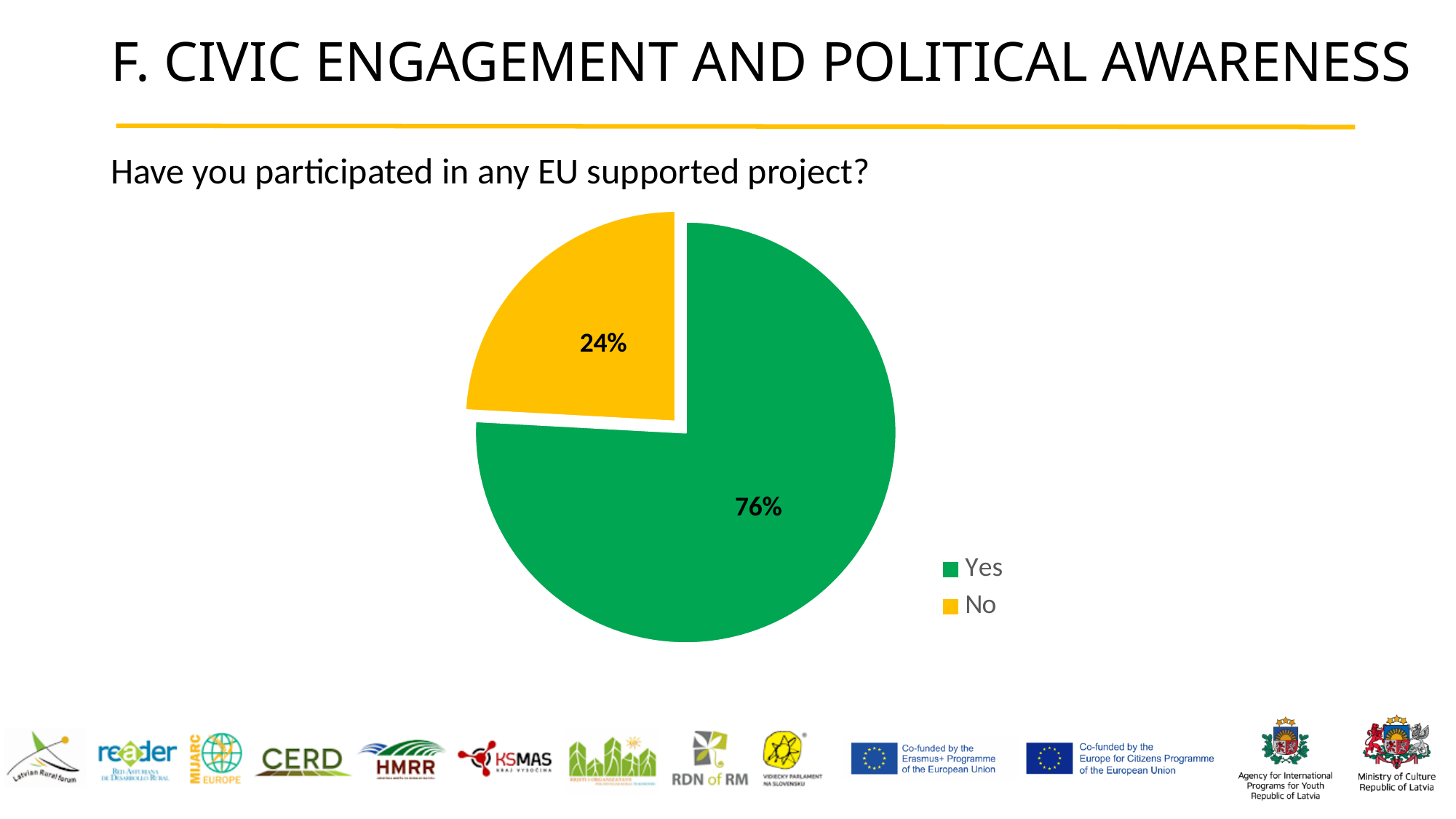
What type of chart is shown on the slide? Pie chart Which is larger, the share for Yes or the share for No? Yes What question does the pie chart present responses to? Have you participated in any EU supported project? What percentage of respondents answered Yes to having participated in an EU supported project? 76% What percentage of respondents answered No to having participated in an EU supported project? 24% What share of the pie does the No slice represent? 24% How many slices does the pie chart have? 2 Which response has the smallest share of the pie chart? No How many entries does the legend list? 2 What is the difference in percentage points between the Yes and No shares? 52 Which response has the largest share of the pie chart? Yes What colour is the Yes slice in the pie chart? Green